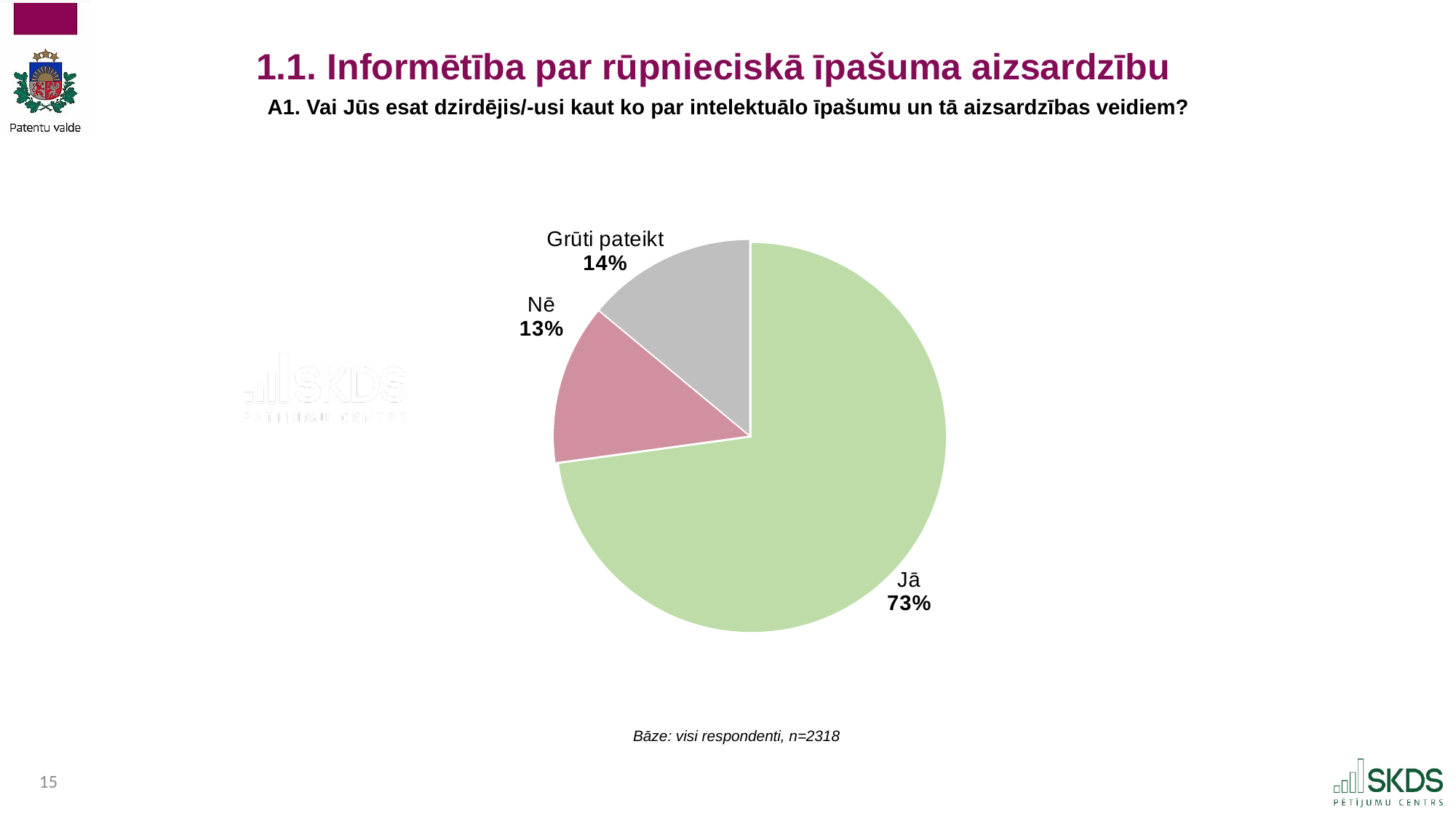
Which answer has the largest share of the pie? Jā What colour is the "Jā" slice of the pie? green What is the difference in percentage points between "Grūti pateikt" and "Nē"? 1 What share of respondents answered "Grūti pateikt"? 14% What share of respondents answered "Jā"? 73% What share of respondents answered "Nē"? 13% What is the base (n) of respondents stated below the chart? n=2318 What is the difference in percentage points between "Jā" and "Nē"? 60 How many slices does the pie chart have? 3 Which is larger, the share for "Jā" or the share for "Grūti pateikt"? Jā Which answer has the smallest share of the pie? Nē What kind of chart is shown on the slide? pie chart